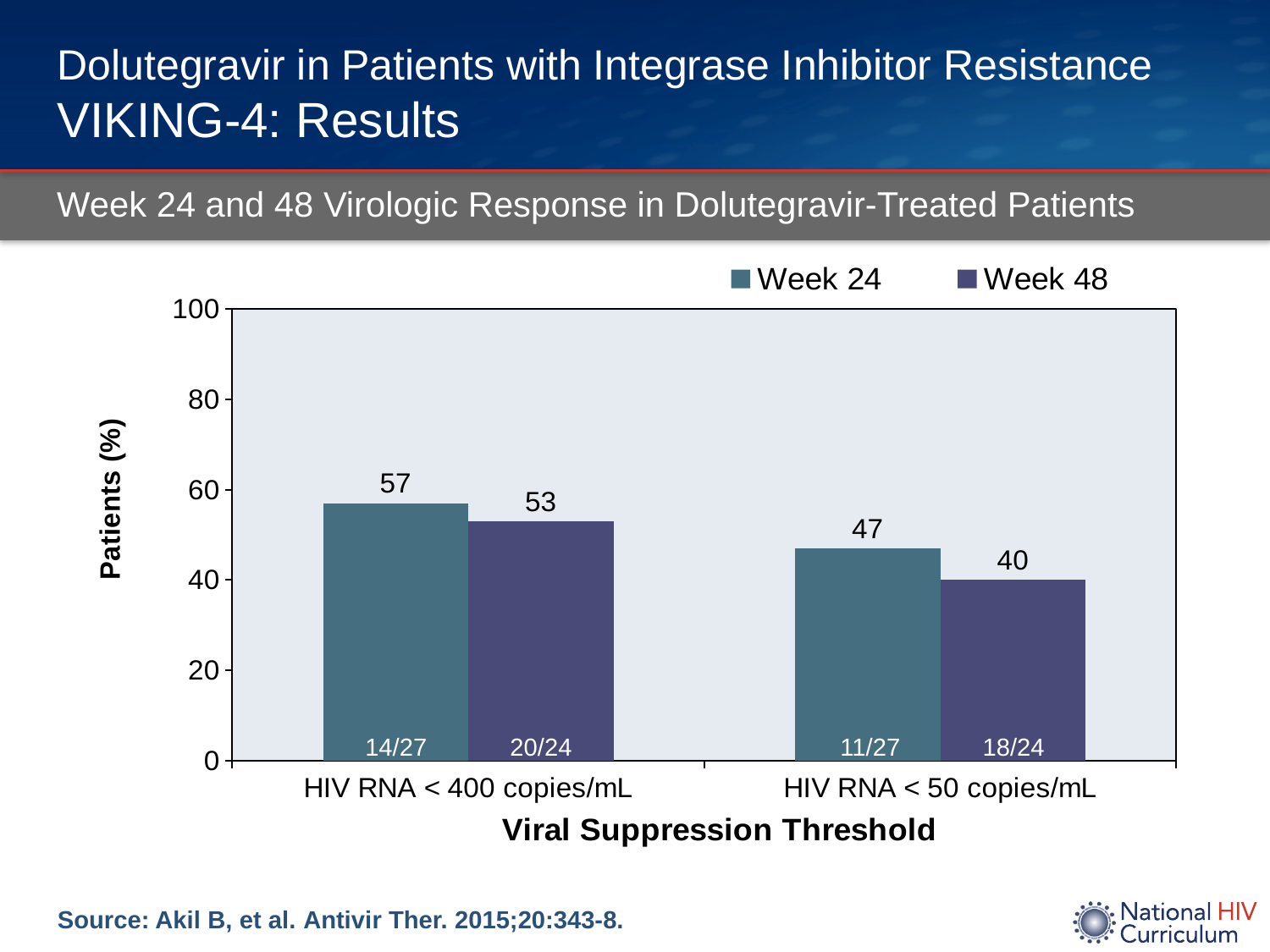
What is the Week 48 value for HIV RNA < 50 copies/mL? 40 Which category has the lowest Week 48 value? HIV RNA < 50 copies/mL How many series does the legend list? 2 What is the Week 24 value for HIV RNA < 400 copies/mL? 57 Is the Week 24 value for HIV RNA < 50 copies/mL greater or less than 60? less What kind of chart is shown on the slide? bar chart Which category has the highest Week 24 value? HIV RNA < 400 copies/mL Which is larger for HIV RNA < 400 copies/mL: the Week 24 value or the Week 48 value? Week 24 How many categories are shown on the x axis? 2 What is the Week 48 value for HIV RNA < 400 copies/mL? 53 What is the difference between the Week 24 and Week 48 values for HIV RNA < 50 copies/mL? 7 What fraction of patients is shown inside the Week 24 bar for HIV RNA < 50 copies/mL? 11/27